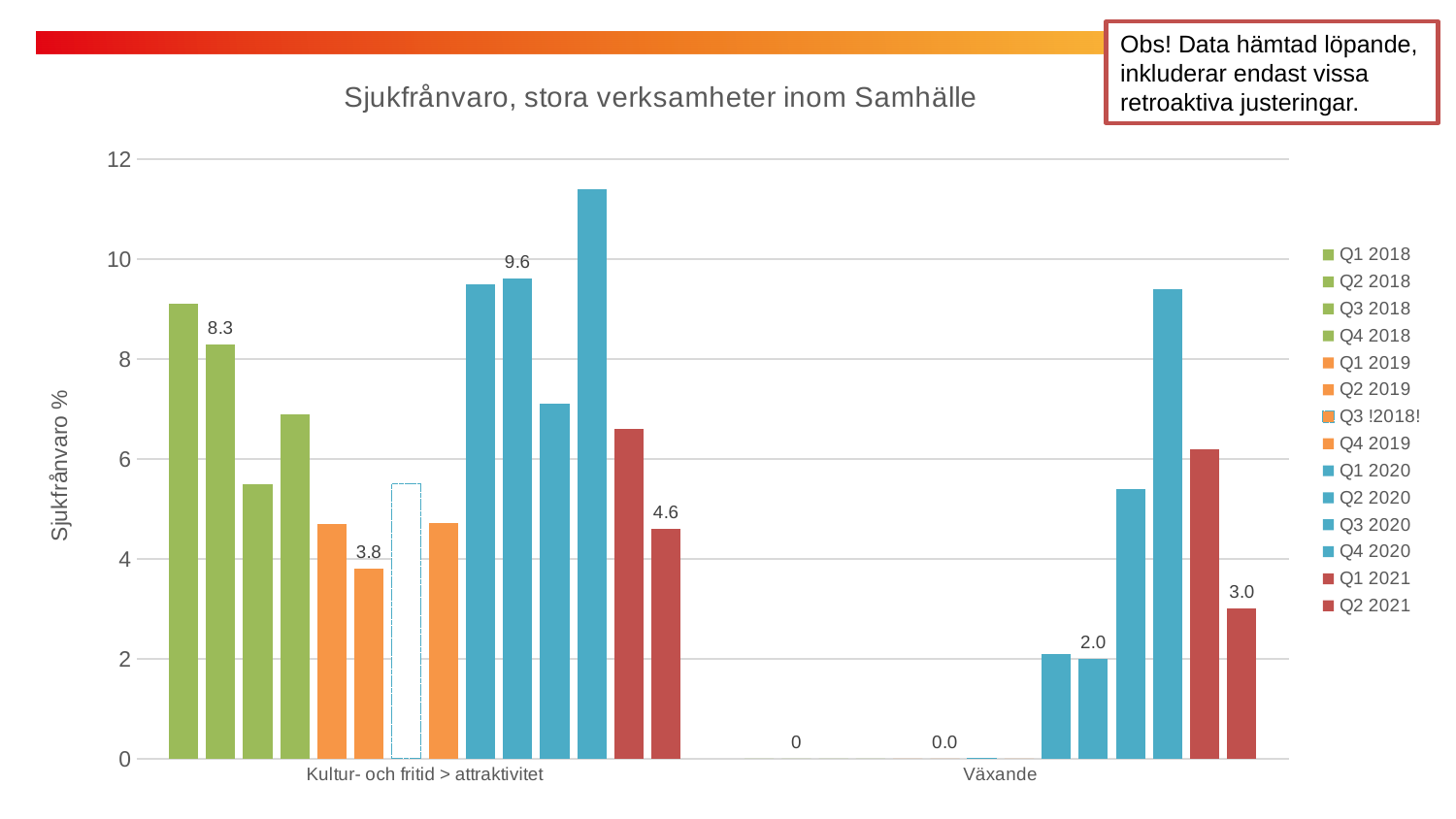
How many categories are shown on the x axis? 2 What is the value for Q2 2021 in the 'Växande' category? 3.0 How many series does the legend list? 14 What is the value for Q2 2020 in the 'Växande' category? 2.0 What is the difference between the Q2 2020 and Q2 2021 values in the 'Kultur- och fritid > attraktivitet' category? 5.0 Is the value for Q4 2020 in the 'Kultur- och fritid > attraktivitet' category greater or less than 10? greater What is the value for Q2 2019 in the 'Kultur- och fritid > attraktivitet' category? 3.8 Is the value for Q4 2020 in the 'Växande' category greater or less than 8? greater What kind of chart is shown on the slide? bar chart Which is larger in the 'Kultur- och fritid > attraktivitet' category: Q2 2018 or Q2 2020? Q2 2020 What is the value for Q2 2020 in the 'Kultur- och fritid > attraktivitet' category? 9.6 Which series has the highest value in the 'Kultur- och fritid > attraktivitet' category? Q4 2020